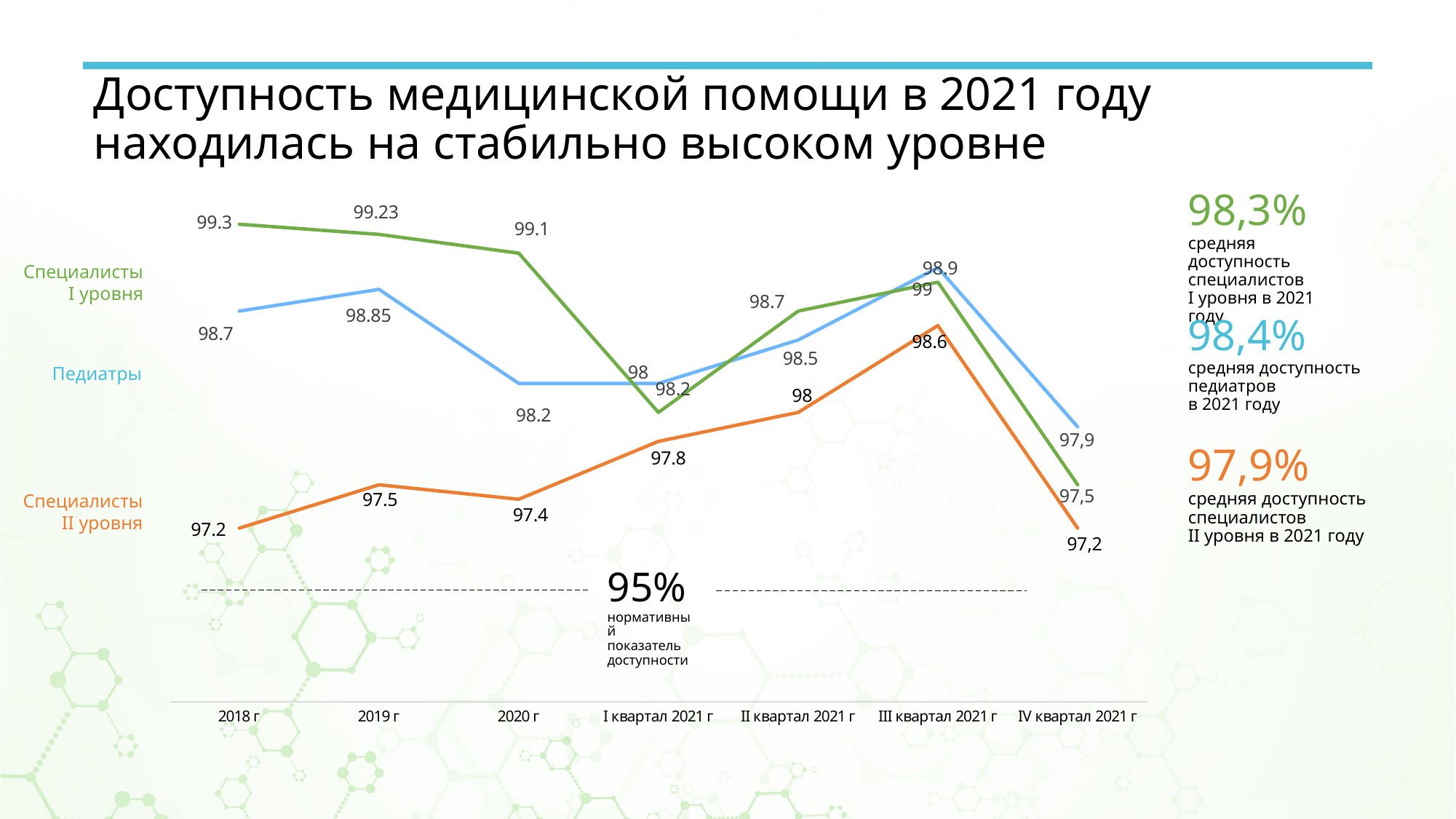
What is the value for Педиатры in IV квартал 2021 г? 97,9 Does the value for Специалисты II уровня rise or fall from I квартал 2021 г to III квартал 2021 г? rise What is the difference between the Специалисты I уровня values for 2018 г and 2020 г? 0.2 What is the value for Специалисты II уровня in III квартал 2021 г? 98.6 What is the value for Педиатры in 2019 г? 98.85 What type of chart is shown on the slide? line chart How many series are plotted on the chart? 3 In 2018 г, which is larger: the value for Специалисты I уровня or for Специалисты II уровня? Специалисты I уровня What is the value for Специалисты I уровня in 2018 г? 99.3 In which period is the value for Специалисты I уровня the lowest? IV квартал 2021 г How many categories are shown along the x axis of the chart? 7 In which period is the value for Специалисты II уровня the highest? III квартал 2021 г